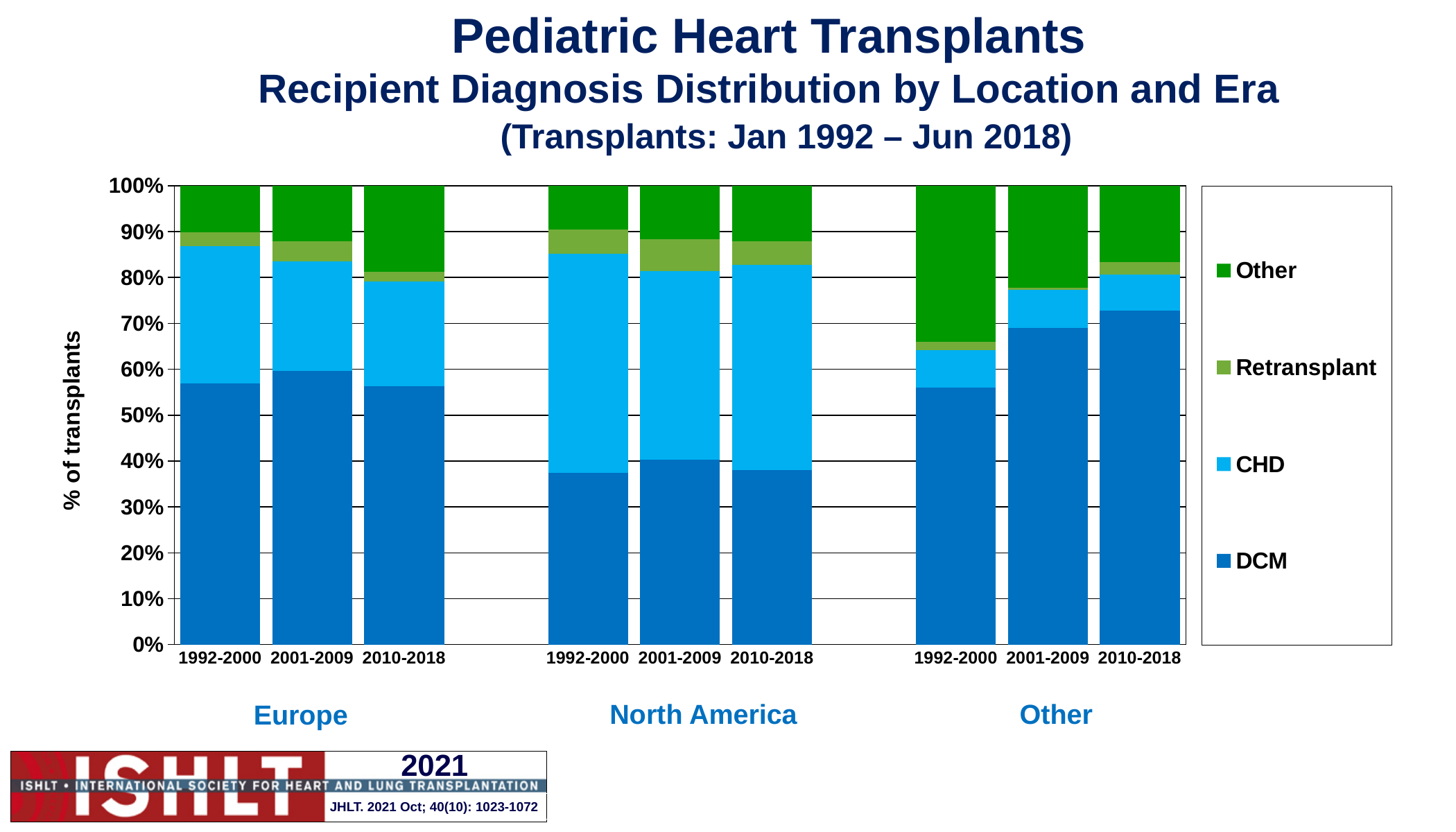
How many series does the legend list? 4 Which has the larger DCM share: Europe 2001-2009 or North America 2001-2009? Europe 2001-2009 Is the DCM share for North America 1992-2000 greater or less than 40%? less Does the DCM share in the Other region rise or fall from 1992-2000 to 2010-2018? rise What kind of chart is shown on the slide? Stacked bar chart Which bar has the largest DCM share? Other 2010-2018 Which has the larger 'Other' diagnosis segment: Other 1992-2000 or Europe 1992-2000? Other 1992-2000 Which region has the smallest DCM shares across all eras? North America What is the label on the y axis? % of transplants How many bars are plotted in the chart? 9 Is the DCM share for Other 2010-2018 greater or less than 70%? greater Is the DCM share for Europe 1992-2000 greater or less than 50%? greater